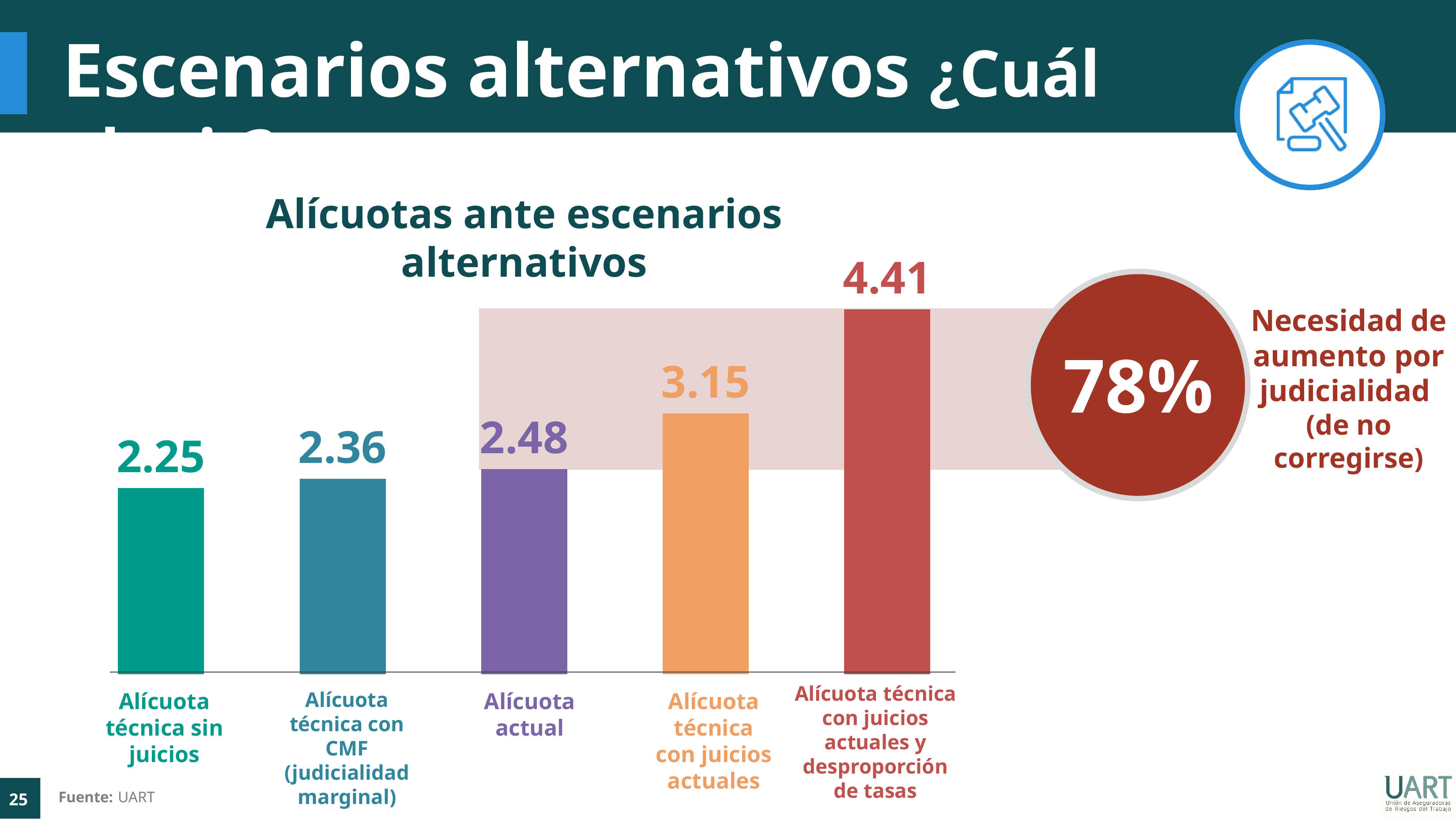
How many bars are shown in the chart? 5 What is the value for 'Alícuota técnica sin juicios'? 2.25 What is the difference between 'Alícuota técnica con juicios actuales y desproporción de tasas' and 'Alícuota actual'? 1.93 What kind of chart is shown on the slide? Bar chart What is the value for 'Alícuota actual'? 2.48 What is the difference between 'Alícuota técnica con CMF (judicialidad marginal)' and 'Alícuota técnica sin juicios'? 0.11 What is the value for 'Alícuota técnica con juicios actuales y desproporción de tasas'? 4.41 What is the title of the chart? Alícuotas ante escenarios alternativos What is the value for 'Alícuota técnica con juicios actuales'? 3.15 Which is larger, 'Alícuota técnica con juicios actuales' or 'Alícuota actual'? Alícuota técnica con juicios actuales Which category has the highest value? Alícuota técnica con juicios actuales y desproporción de tasas Which category has the lowest value? Alícuota técnica sin juicios